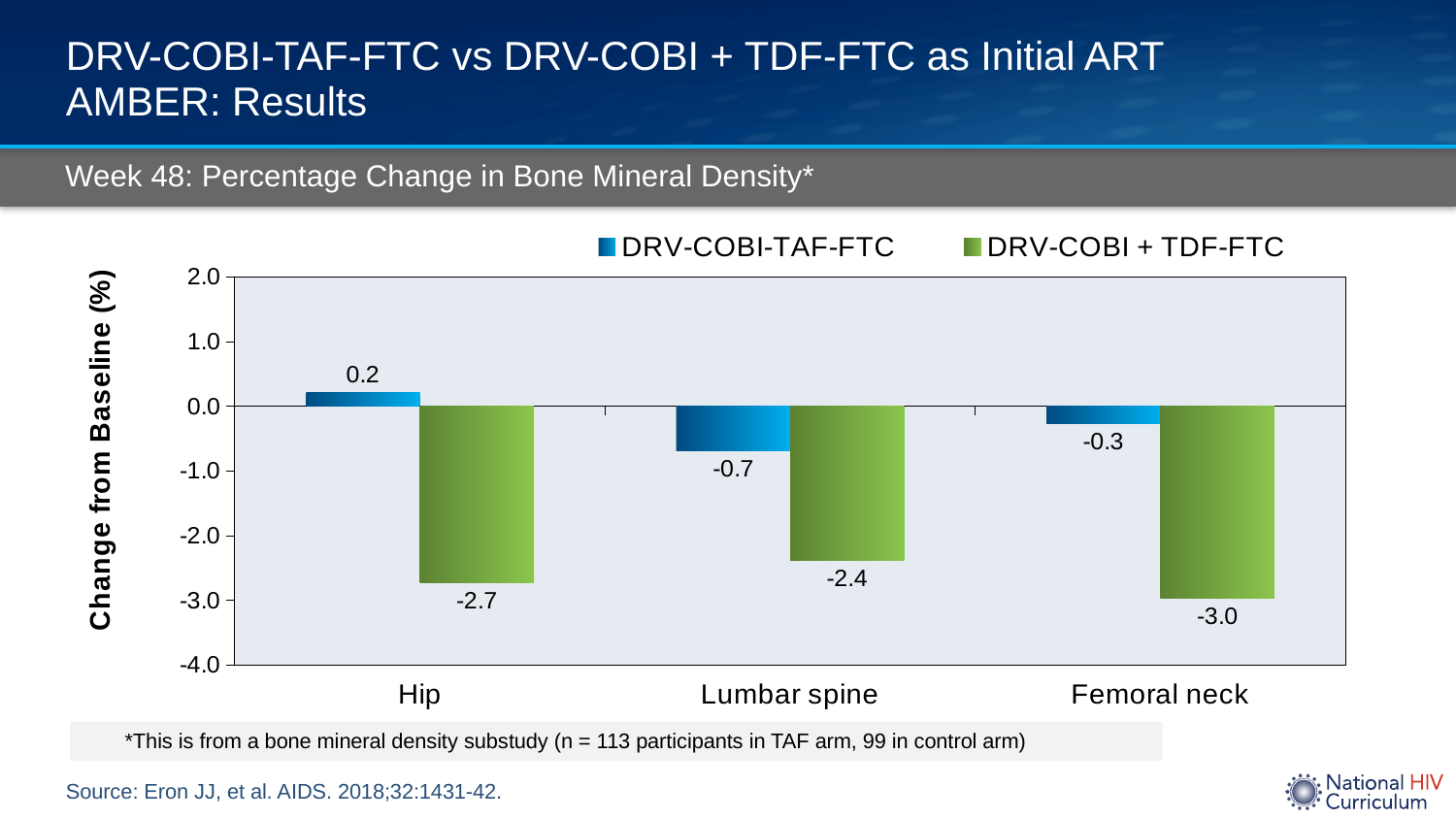
How many bone sites (categories) are shown on the x axis? 3 At the femoral neck, which regimen has the larger (less negative) change from baseline? DRV-COBI-TAF-FTC What is the percentage change from baseline at the lumbar spine for DRV-COBI + TDF-FTC? -2.4 What kind of chart is shown on the slide? Bar chart What is the percentage change from baseline at the hip for DRV-COBI + TDF-FTC? -2.7 What is the percentage change from baseline at the femoral neck for DRV-COBI-TAF-FTC? -0.3 What is the percentage change from baseline in bone mineral density at the hip for DRV-COBI-TAF-FTC? 0.2 How many series does the legend list? 2 For DRV-COBI-TAF-FTC, which site shows the highest change from baseline? Hip For DRV-COBI + TDF-FTC, which site shows the lowest (most negative) change from baseline? Femoral neck What is the difference between the DRV-COBI-TAF-FTC and DRV-COBI + TDF-FTC values at the lumbar spine? 1.7 Is the value for DRV-COBI + TDF-FTC at the hip greater or less than -2.0? less